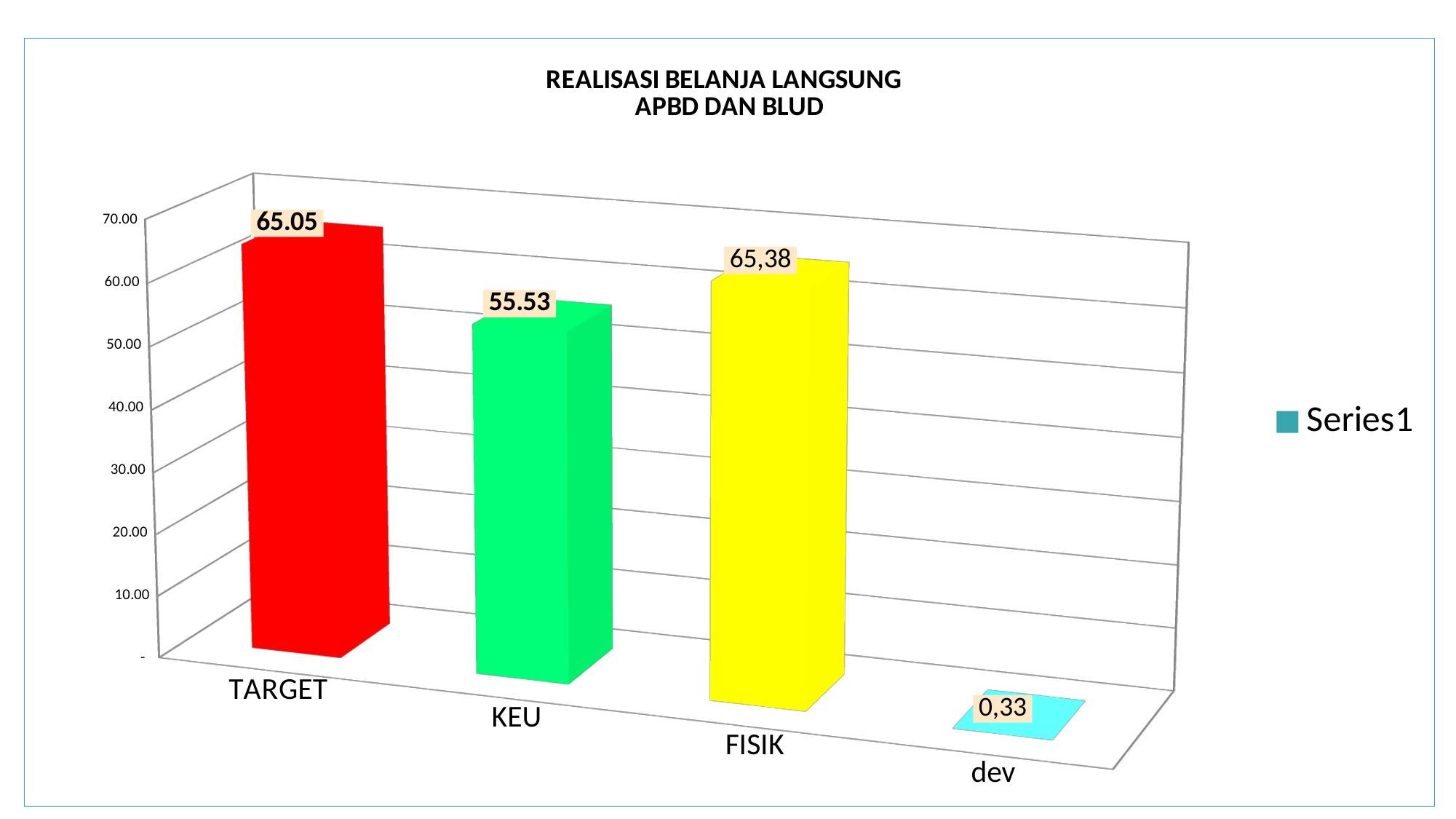
Which category has the lowest value? dev How many series does the legend list? 1 What is the value for FISIK? 65,38 What is the difference between the values for TARGET and KEU? 9.52 What is the value for TARGET? 65.05 Is the value for KEU greater or less than 50? greater How many categories are shown on the x axis? 4 What is the title of the chart? REALISASI BELANJA LANGSUNG APBD DAN BLUD Which is larger, the value for TARGET or the value for KEU? TARGET What is the value for dev? 0,33 What kind of chart is shown on the slide? bar chart What is the value for KEU? 55.53